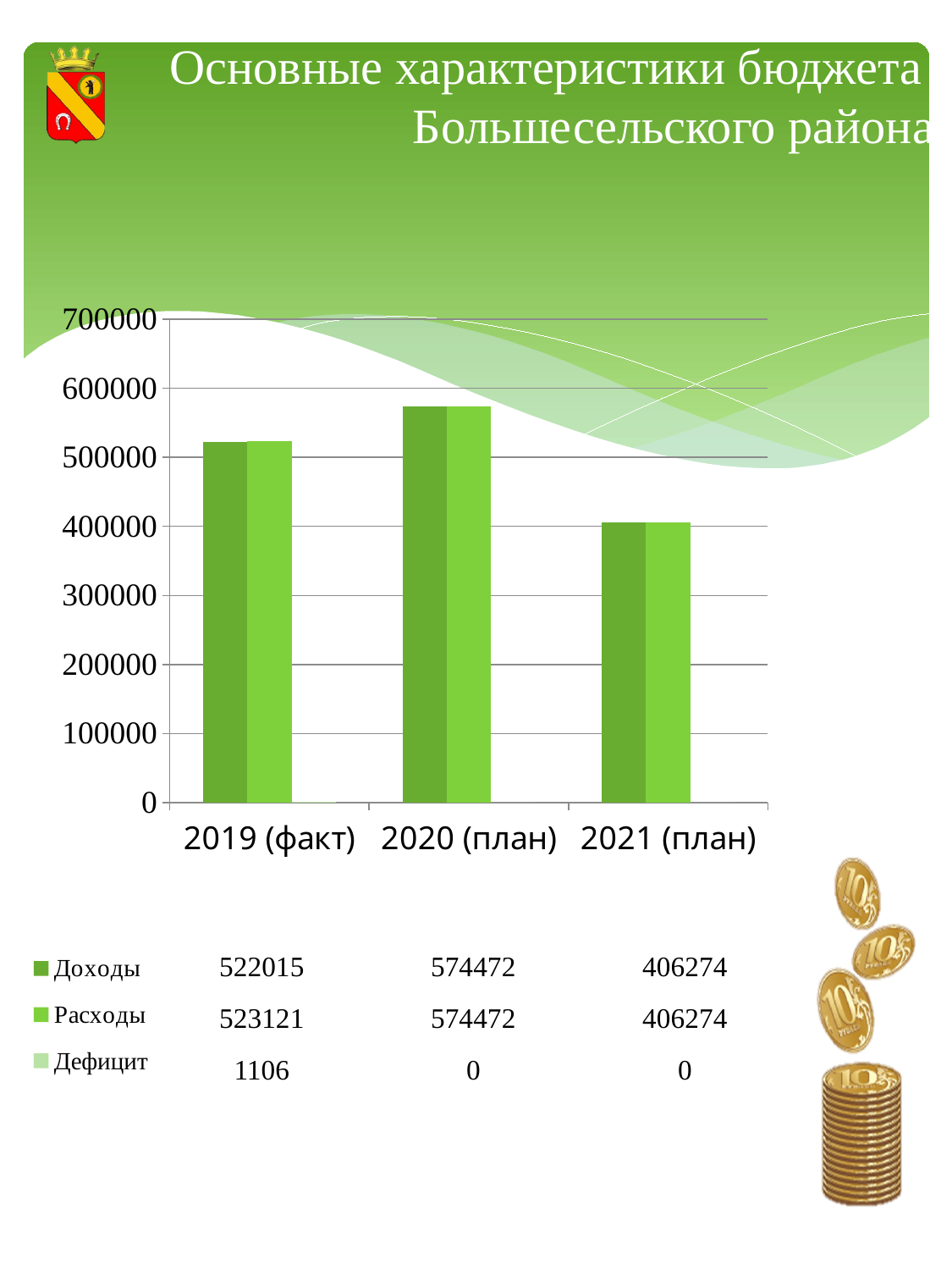
What is the value of Доходы for 2020 (план)? 574472 What is the difference between Доходы for 2020 (план) and Доходы for 2021 (план)? 168198 How many categories are shown on the x axis? 3 What is the value of Расходы for 2021 (план)? 406274 What is the value of Расходы for 2019 (факт)? 523121 What kind of chart is shown on the slide? bar chart Which category has the lowest value for Расходы? 2021 (план) What is the value of Доходы for 2019 (факт)? 522015 Which category has the highest value for Доходы? 2020 (план) How many series does the legend list? 3 What is the value of Дефицит for 2019 (факт)? 1106 Which is larger: Доходы for 2019 (факт) or Доходы for 2021 (план)? Доходы for 2019 (факт)